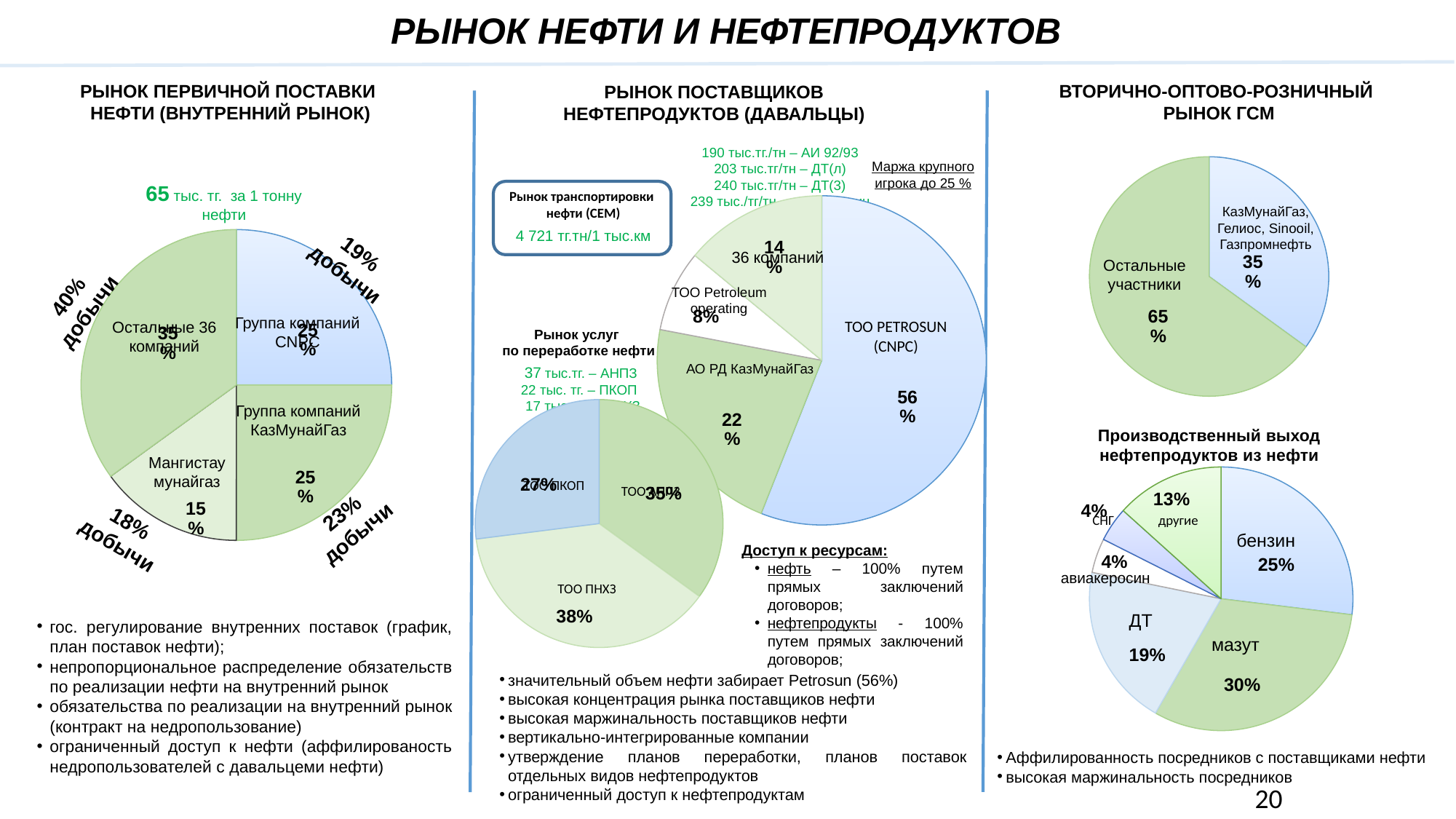
On the pie chart under 'ВТОРИЧНО-ОПТОВО-РОЗНИЧНЫЙ РЫНОК ГСМ', what share do 'Остальные участники' have? 65% On the pie chart under 'РЫНОК ПОСТАВЩИКОВ НЕФТЕПРОДУКТОВ (ДАВАЛЬЦЫ)', what is the difference between the shares of 'ТОО PETROSUN (CNPC)' and 'АО РД КазМунайГаз'? 34% What type of chart is used for 'Производственный выход нефтепродуктов из нефти'? Pie chart How many slices does the pie chart under 'РЫНОК ПЕРВИЧНОЙ ПОСТАВКИ НЕФТИ (ВНУТРЕННИЙ РЫНОК)' have? 4 On the pie chart under 'РЫНОК ПОСТАВЩИКОВ НЕФТЕПРОДУКТОВ (ДАВАЛЬЦЫ)', what share does 'ТОО PETROSUN (CNPC)' have? 56% On the pie chart under 'РЫНОК ПЕРВИЧНОЙ ПОСТАВКИ НЕФТИ (ВНУТРЕННИЙ РЫНОК)', which slice is the largest? Остальные 36 компаний On the pie chart under 'РЫНОК ПОСТАВЩИКОВ НЕФТЕПРОДУКТОВ (ДАВАЛЬЦЫ)', which slice is the smallest? ТОО Petroleum operating On the 'Производственный выход нефтепродуктов из нефти' pie chart, what share does 'мазут' have? 30% On the 'Производственный выход нефтепродуктов из нефти' pie chart, which is larger: 'бензин' or 'ДТ'? бензин How many slices does the 'Рынок услуг по переработке нефти' pie chart have? 3 On the 'Рынок услуг по переработке нефти' pie chart, what share does 'ТОО ПНХЗ' have? 38% On the pie chart under 'РЫНОК ПЕРВИЧНОЙ ПОСТАВКИ НЕФТИ (ВНУТРЕННИЙ РЫНОК)', what share does 'Мангистаумунайгаз' have? 15%